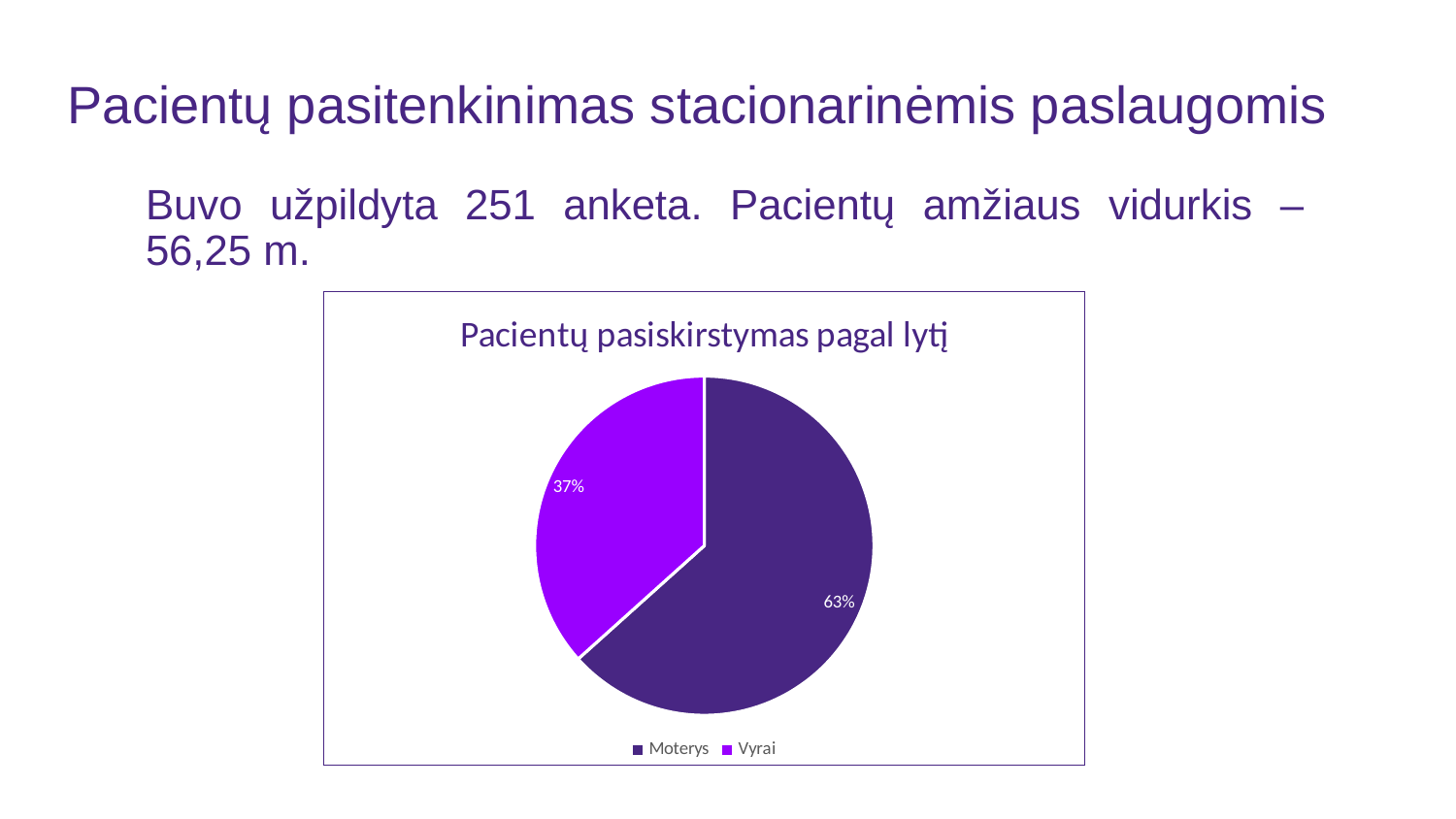
What is the title of the chart? Pacientų pasiskirstymas pagal lytį Which is larger, the Moterys slice or the Vyrai slice? Moterys What kind of chart is shown on the slide? Pie chart How many entries does the chart legend list? 2 Which category has the largest slice of the pie? Moterys What is the difference in percentage points between the Moterys and Vyrai slices? 26 What share of the pie does Moterys represent? 63% What share of the pie does Vyrai represent? 37% How many categories are shown in the pie chart? 2 Which category has the smallest slice of the pie? Vyrai Which legend entry is shown in the brighter purple colour? Vyrai